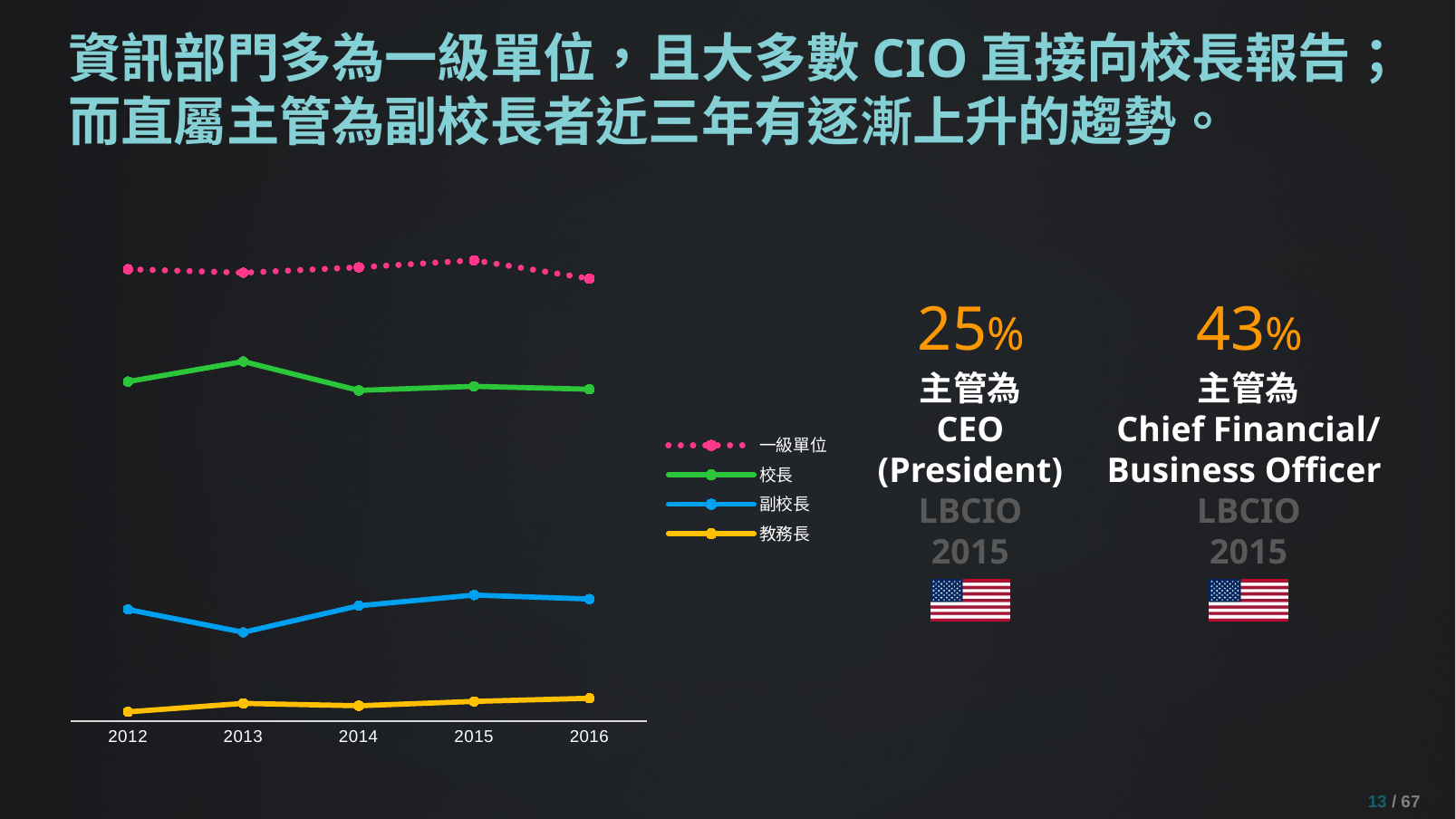
What kind of chart is shown on the slide? line chart Which series has the highest values across all years in the chart? 一級單位 How many series does the chart's legend list? 4 In 2016, which is larger: the value for 校長 or the value for 副校長? 校長 What colour is the line for the 副校長 series? blue Which series has the lowest values across all years in the chart? 教務長 Does the 教務長 series rise or fall from 2012 to 2016? rise In which year does the 副校長 series reach its lowest point? 2013 How many years are shown on the x axis of the chart? 5 In which year does the 校長 series reach its highest point? 2013 Does the 副校長 series rise or fall from 2013 to 2015? rise Which series in the chart is drawn with a dotted line? 一級單位